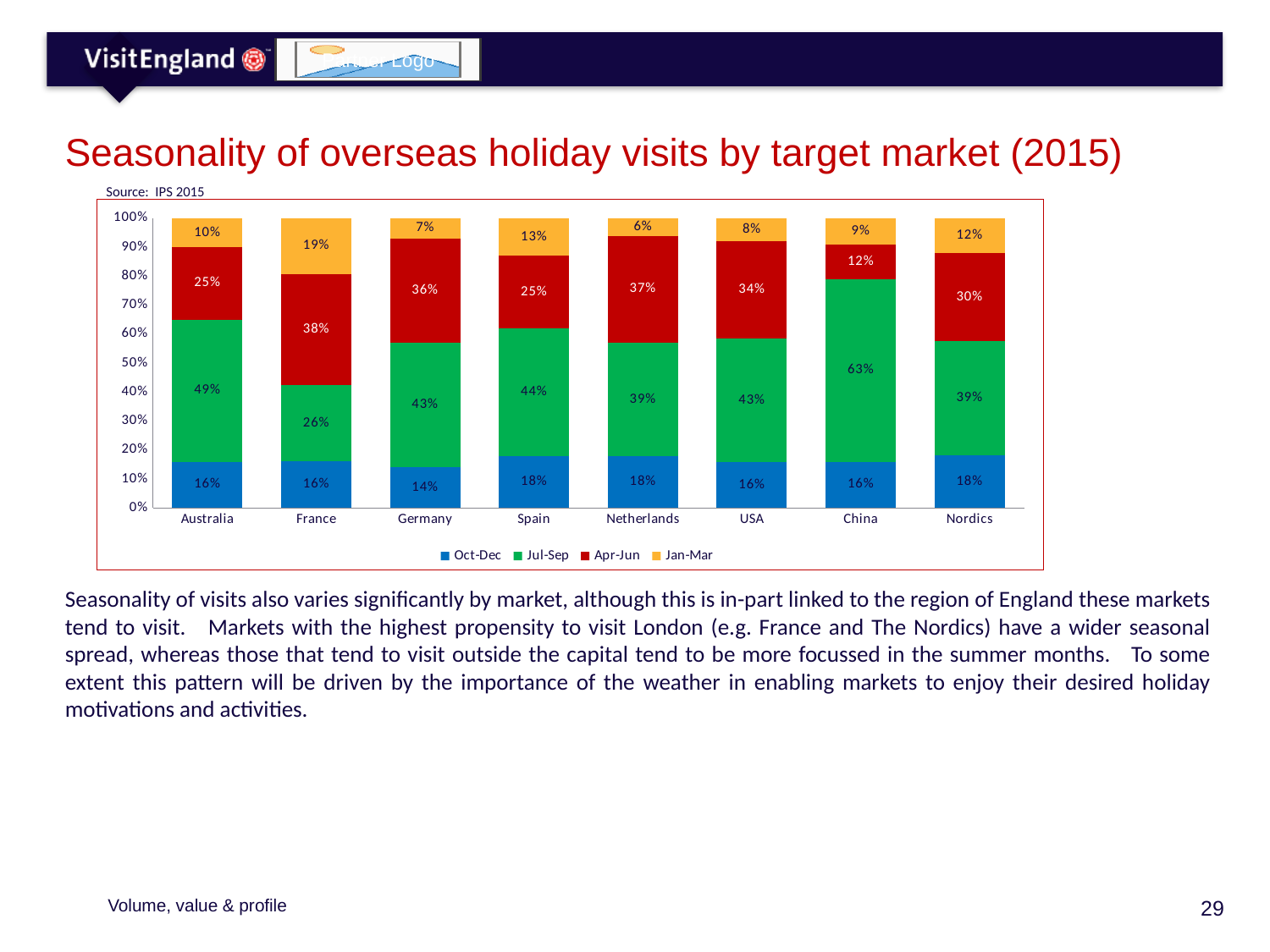
Which market has the highest Jul-Sep share? China What is the Jul-Sep share for China? 63% What kind of chart is shown on the slide? Stacked bar chart Which market has the lowest Jan-Mar share? Netherlands What is the difference between the Apr-Jun shares for France and China? 26% Is the Apr-Jun share larger for Germany or for Spain? Germany Which market has the lowest Jul-Sep share? France How many series does the legend list? 4 What is the Jan-Mar share for France? 19% What is the Oct-Dec share for Germany? 14% How many markets are shown on the x axis? 8 What is the Apr-Jun share for the Netherlands? 37%